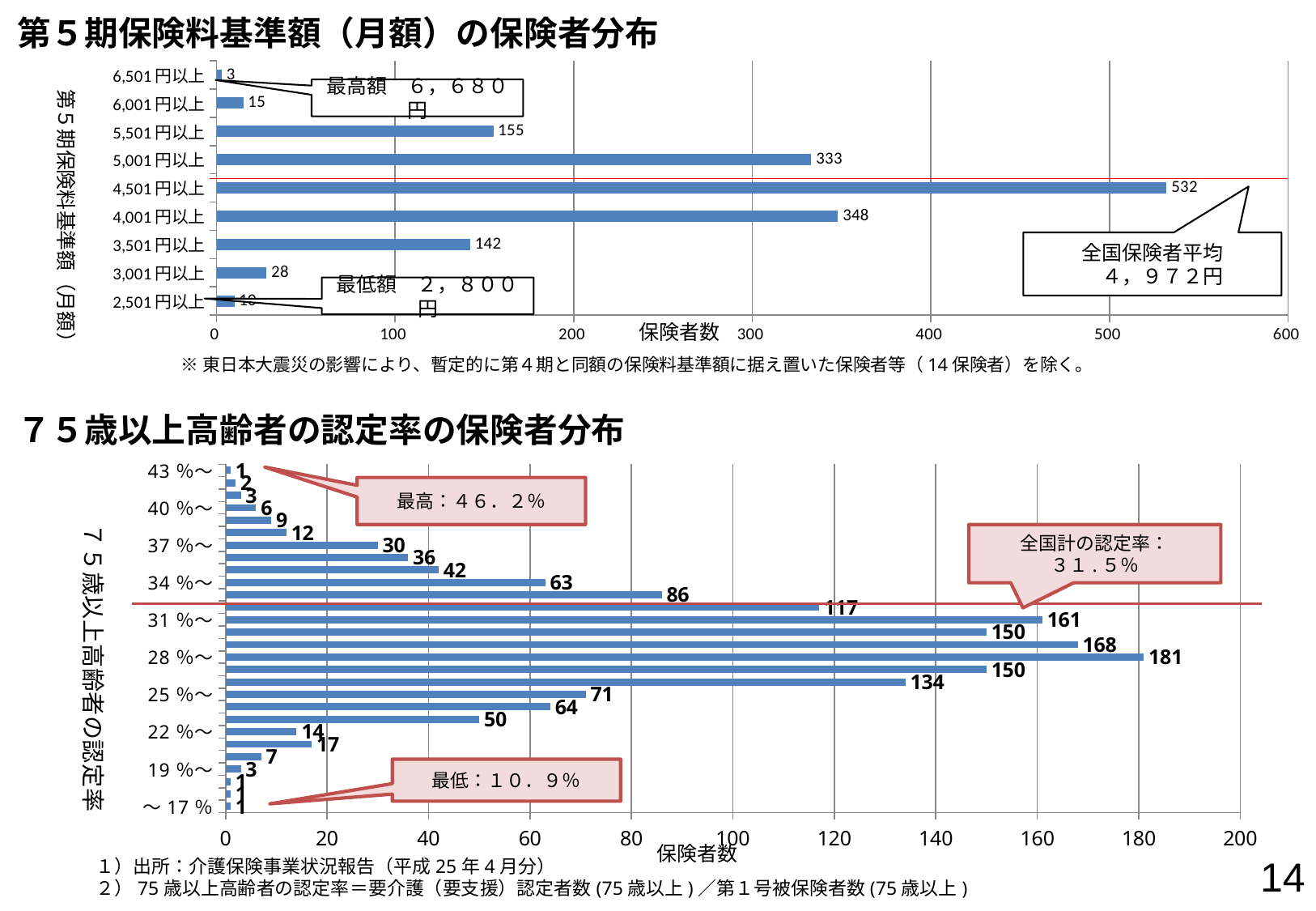
In the top chart (第５期保険料基準額（月額）の保険者分布), which category has the highest value? 4,501円以上 In the top chart (第５期保険料基準額（月額）の保険者分布), what kind of chart is shown? Bar chart In the top chart (第５期保険料基準額（月額）の保険者分布), what is the value for 4,501円以上? 532 In the bottom chart (７５歳以上高齢者の認定率の保険者分布), what is the highest value shown in the callout (最高)? 46.2% In the top chart (第５期保険料基準額（月額）の保険者分布), what is the value for 5,001円以上? 333 In the top chart (第５期保険料基準額（月額）の保険者分布), what national average value is shown in the callout (全国保険者平均)? 4,972円 In the bottom chart (７５歳以上高齢者の認定率の保険者分布), what is the value for 31%〜? 161 In the bottom chart (７５歳以上高齢者の認定率の保険者分布), what is the value for 28%〜? 181 In the bottom chart (７５歳以上高齢者の認定率の保険者分布), what is the value for 34%〜? 63 In the top chart (第５期保険料基準額（月額）の保険者分布), what is the difference between the values for 4,001円以上 and 3,501円以上? 206 In the bottom chart (７５歳以上高齢者の認定率の保険者分布), what is the difference between the values for 25%〜 and 22%〜? 57 In the top chart (第５期保険料基準額（月額）の保険者分布), which is larger, the value for 5,501円以上 or the value for 3,501円以上? 5,501円以上